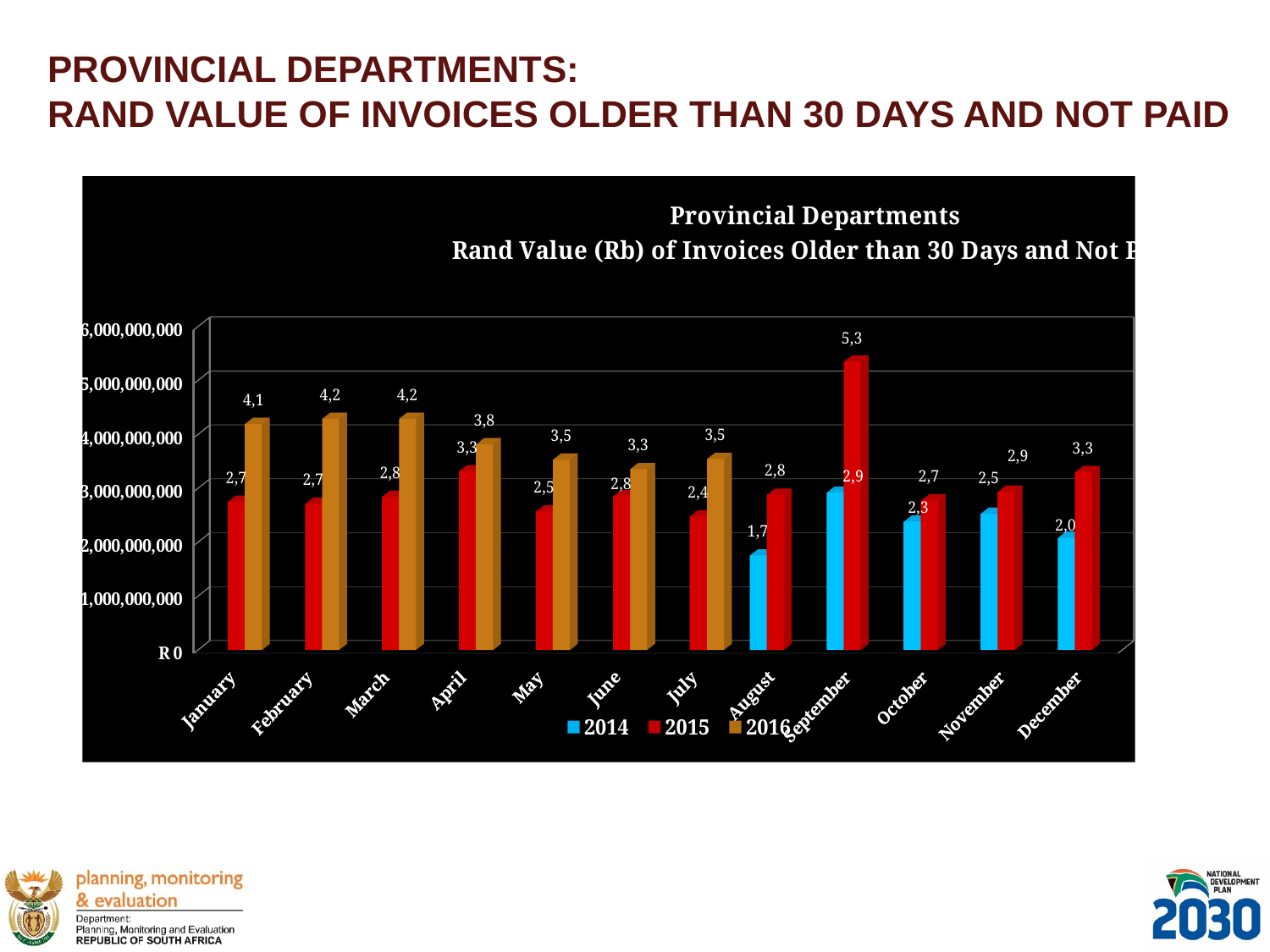
What is the value for 2014 in December? 2,0 Is the 2015 value for September greater or less than 5,000,000,000? greater In which month is the 2015 value highest? September Do the 2016 values rise or fall from March to June? fall What is the value for 2016 in January? 4,1 What is the difference between the 2016 and 2015 values in January? 1,4 What is the value for 2015 in September? 5,3 What kind of chart is shown on the slide? bar chart How many series does the legend list? 3 Which is larger, the 2015 value for April or the 2015 value for May? April In which month is the 2014 value lowest? August How many months are shown on the x axis? 12